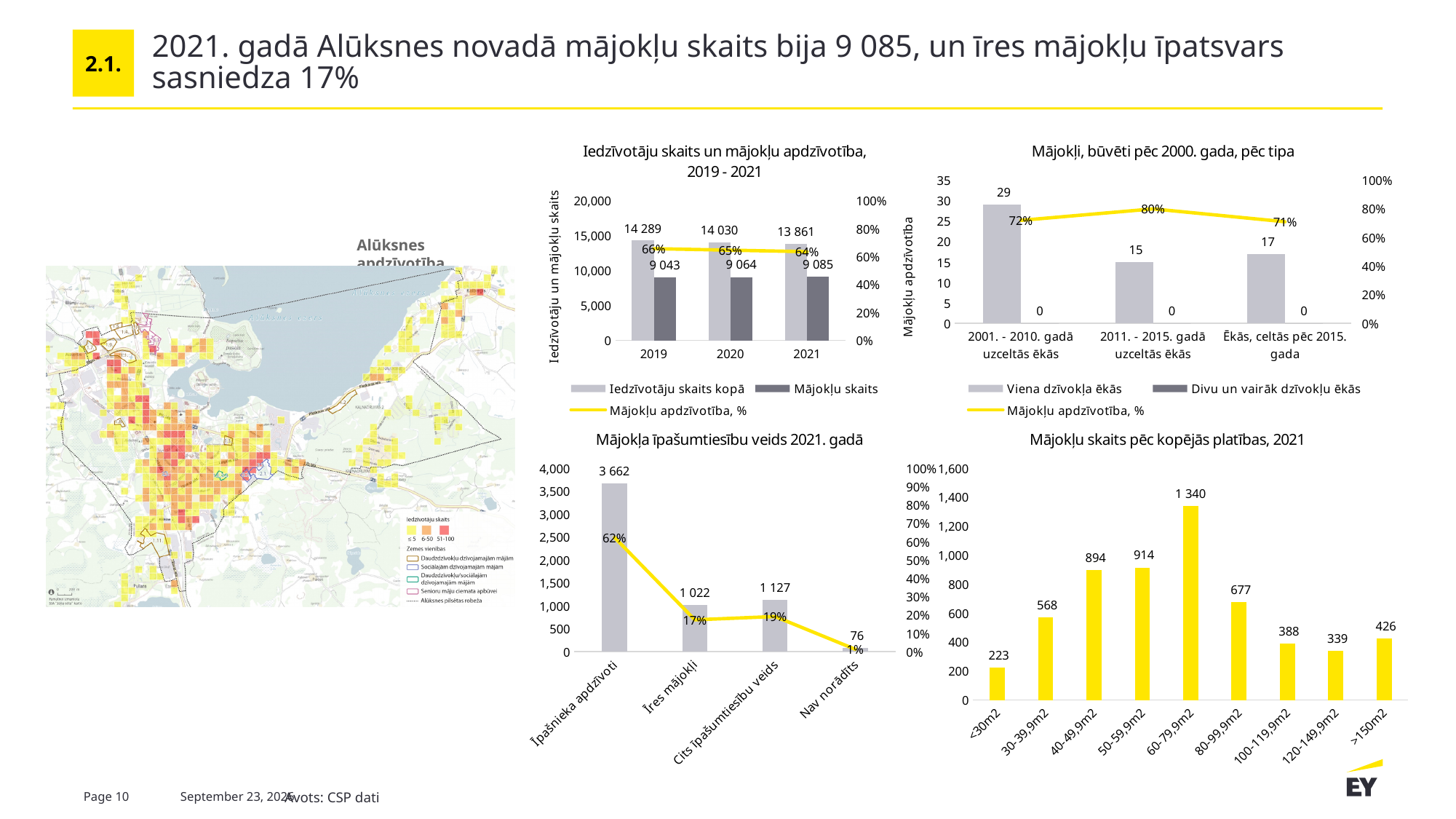
In the chart 'Mājokļu skaits pēc kopējās platības, 2021', how many size categories are shown on the x axis? 9 In the chart 'Mājokļa īpašumtiesību veids 2021. gadā', which category has the lowest value? Nav norādīts In the chart 'Mājokļu skaits pēc kopējās platības, 2021', what is the difference between the values for 50-59,9m2 and 40-49,9m2? 20 In the chart 'Mājokļu skaits pēc kopējās platības, 2021', what is the value for the <30m2 category? 223 In the chart 'Mājokļi, būvēti pēc 2000. gada, pēc tipa', what is the Viena dzīvokļa ēkās value for '2001. - 2010. gadā uzceltās ēkās'? 29 In the chart 'Mājokļi, būvēti pēc 2000. gada, pēc tipa', which period has the highest Mājokļu apdzīvotība, %? 2011. - 2015. gadā uzceltās ēkās In the chart 'Iedzīvotāju skaits un mājokļu apdzīvotība, 2019 - 2021', does the Iedzīvotāju skaits kopā series rise or fall from 2019 to 2021? fall In the chart 'Iedzīvotāju skaits un mājokļu apdzīvotība, 2019 - 2021', how many series does the legend list? 3 In the chart 'Iedzīvotāju skaits un mājokļu apdzīvotība, 2019 - 2021', what is the Mājokļu skaits value for 2021? 9 085 In the chart 'Mājokļa īpašumtiesību veids 2021. gadā', what percentage is shown for Īpašnieka apdzīvoti? 62% In the chart 'Mājokļa īpašumtiesību veids 2021. gadā', what is the value for Īres mājokļi? 1 022 In the chart 'Mājokļu skaits pēc kopējās platības, 2021', which size category has the highest number of dwellings? 60-79,9m2